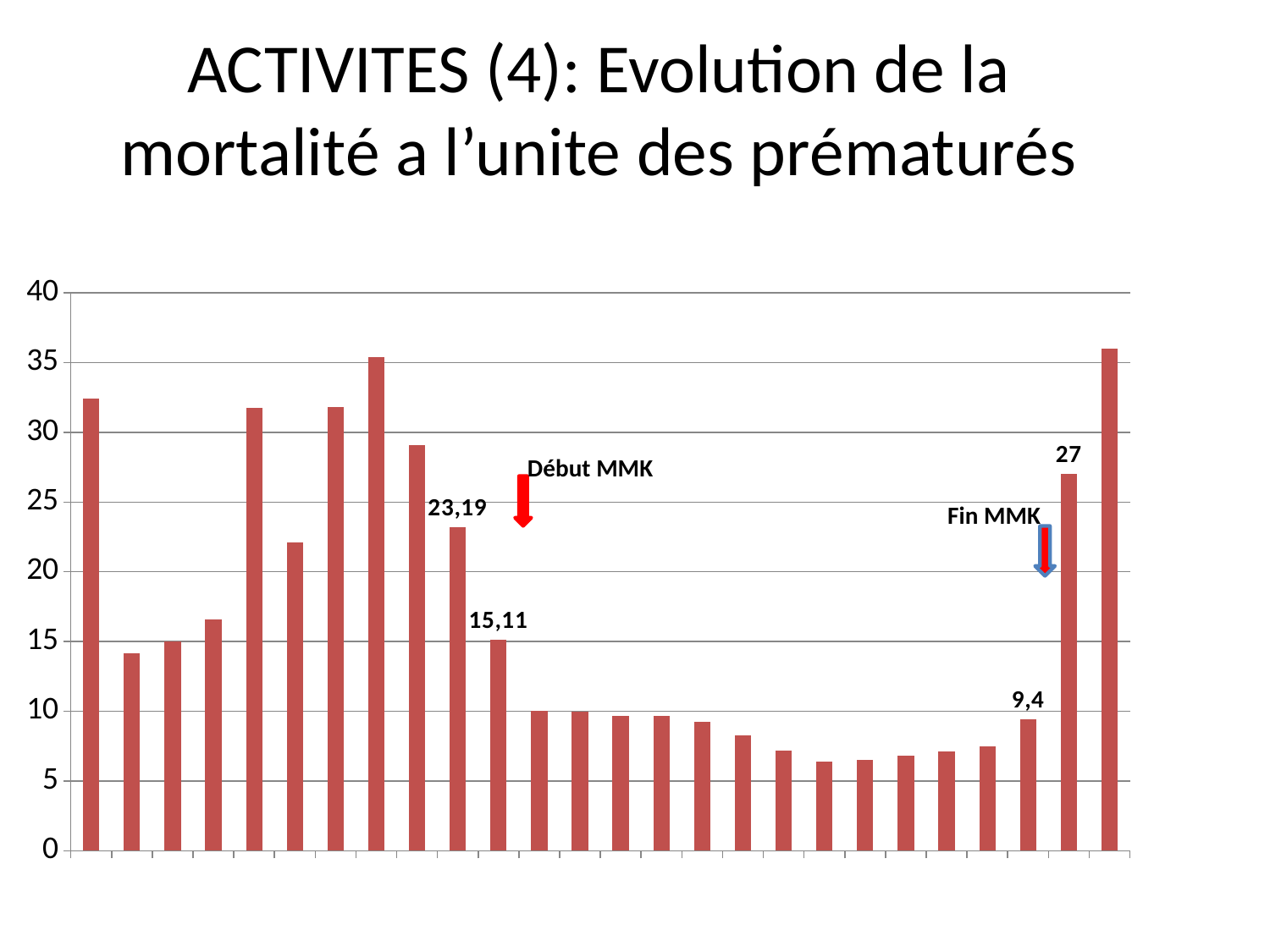
What value is printed on the bar immediately to the left of the blue 'Fin MMK' arrow? 9,4 What kind of chart is shown on the slide? bar chart What label is written next to the red arrow on the chart? Début MMK Is the value of the rightmost bar greater or less than 35? greater How many bars are plotted in the chart? 26 What is the difference between the bars labelled 27 and 9,4? 17,6 What value is printed on the bar two positions to the left of the red 'Début MMK' arrow? 23,19 What value is printed on the bar immediately to the left of the red 'Début MMK' arrow? 15,11 What is the difference between the bars labelled 23,19 and 15,11? 8,08 What value is printed on the bar immediately to the right of the blue 'Fin MMK' arrow? 27 Which is larger, the bar labelled 23,19 or the bar labelled 27? 27 Is the value of the leftmost bar greater or less than 30? greater